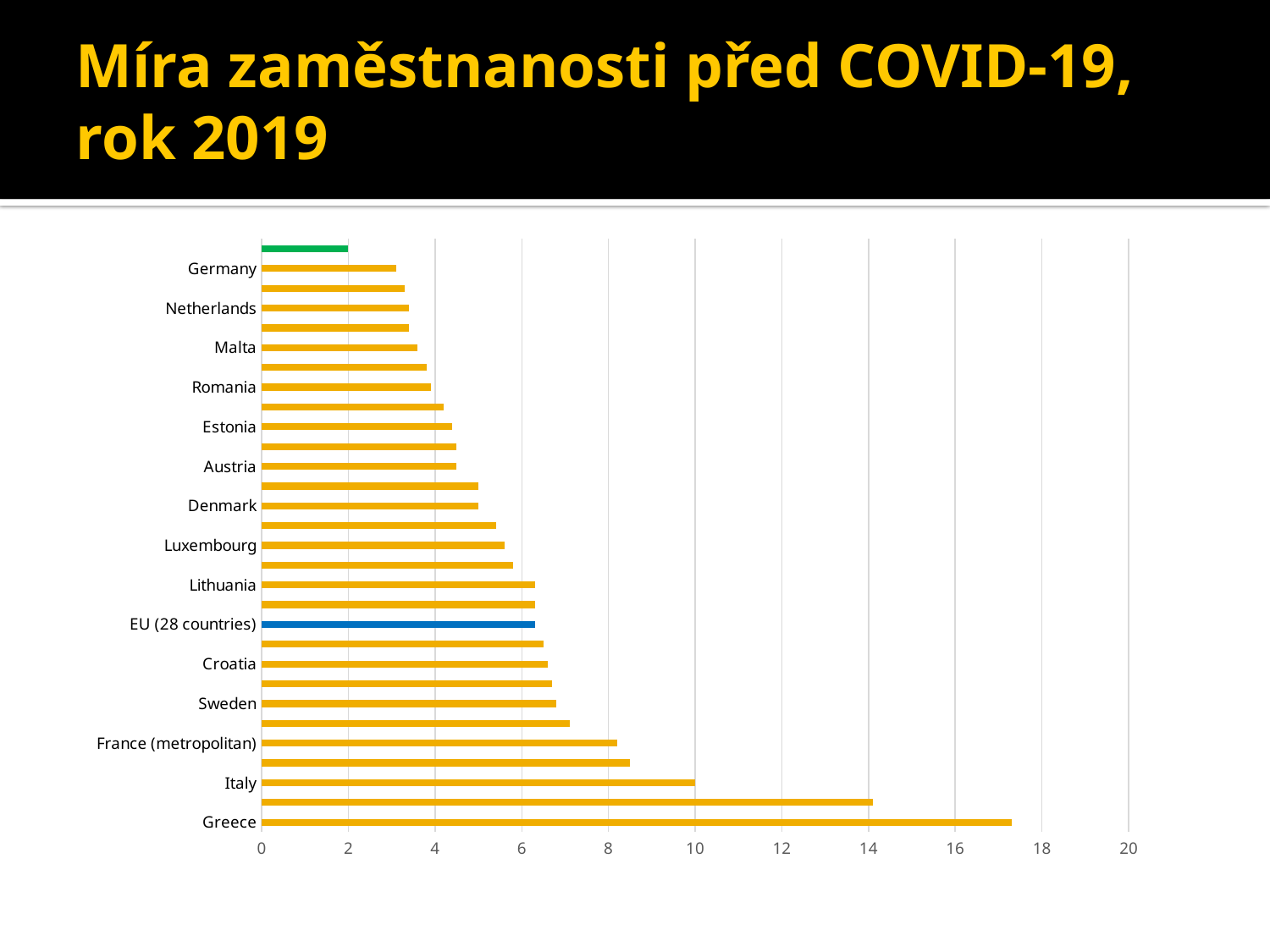
What kind of chart is shown on the slide? bar chart Is the value for Germany greater or less than 4? less Which labeled country has the shortest bar in the chart? Germany Is the value for Denmark greater or less than 6? less Is the value for Italy greater or less than 8? greater Which labeled country has the longest bar in the chart? Greece What colour is the bar for EU (28 countries)? blue Which has the larger value, Germany or Malta? Malta Which has the larger value, Italy or Sweden? Italy